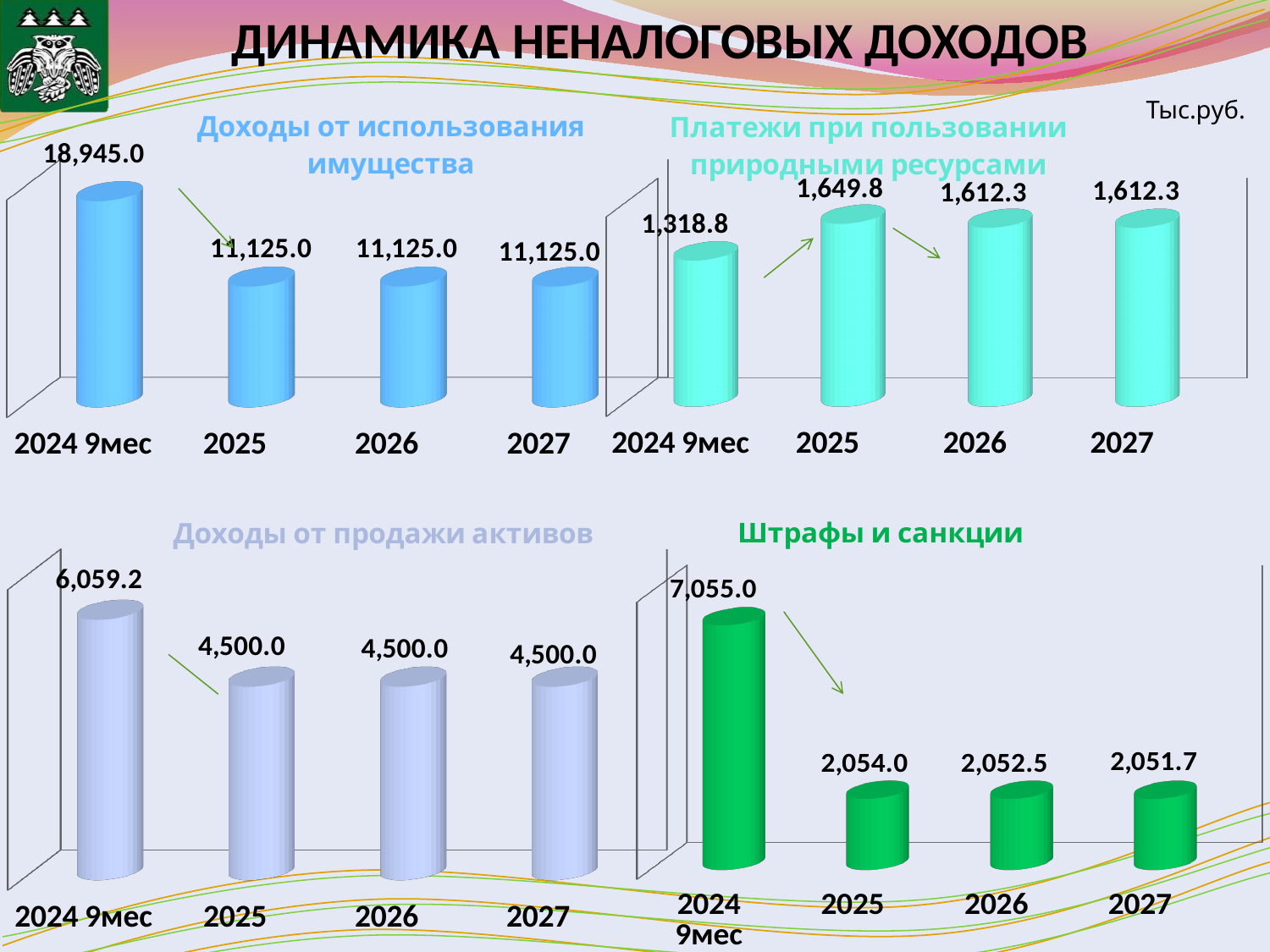
What unit of measurement is indicated in the top right corner of the slide? Тыс.руб. In the chart 'Платежи при пользовании природными ресурсами', which category has the lowest value? 2024 9мес In the chart 'Доходы от использования имущества', what is the value for 2024 9мес? 18,945.0 In the chart 'Доходы от продажи активов', which category has the highest value? 2024 9мес In the chart 'Платежи при пользовании природными ресурсами', what is the value for 2025? 1,649.8 In the chart 'Доходы от использования имущества', what is the difference between the values for 2024 9мес and 2025? 7,820.0 In the chart 'Платежи при пользовании природными ресурсами', which is larger, the value for 2025 or the value for 2026? 2025 What kind of chart is 'Штрафы и санкции'? Bar chart In the chart 'Штрафы и санкции', what is the difference between the values for 2024 9мес and 2025? 5,001.0 In the chart 'Штрафы и санкции', do the values rise or fall from 2025 to 2027? Fall How many categories are shown in the chart 'Доходы от продажи активов'? 4 In the chart 'Штрафы и санкции', what is the value for 2027? 2,051.7